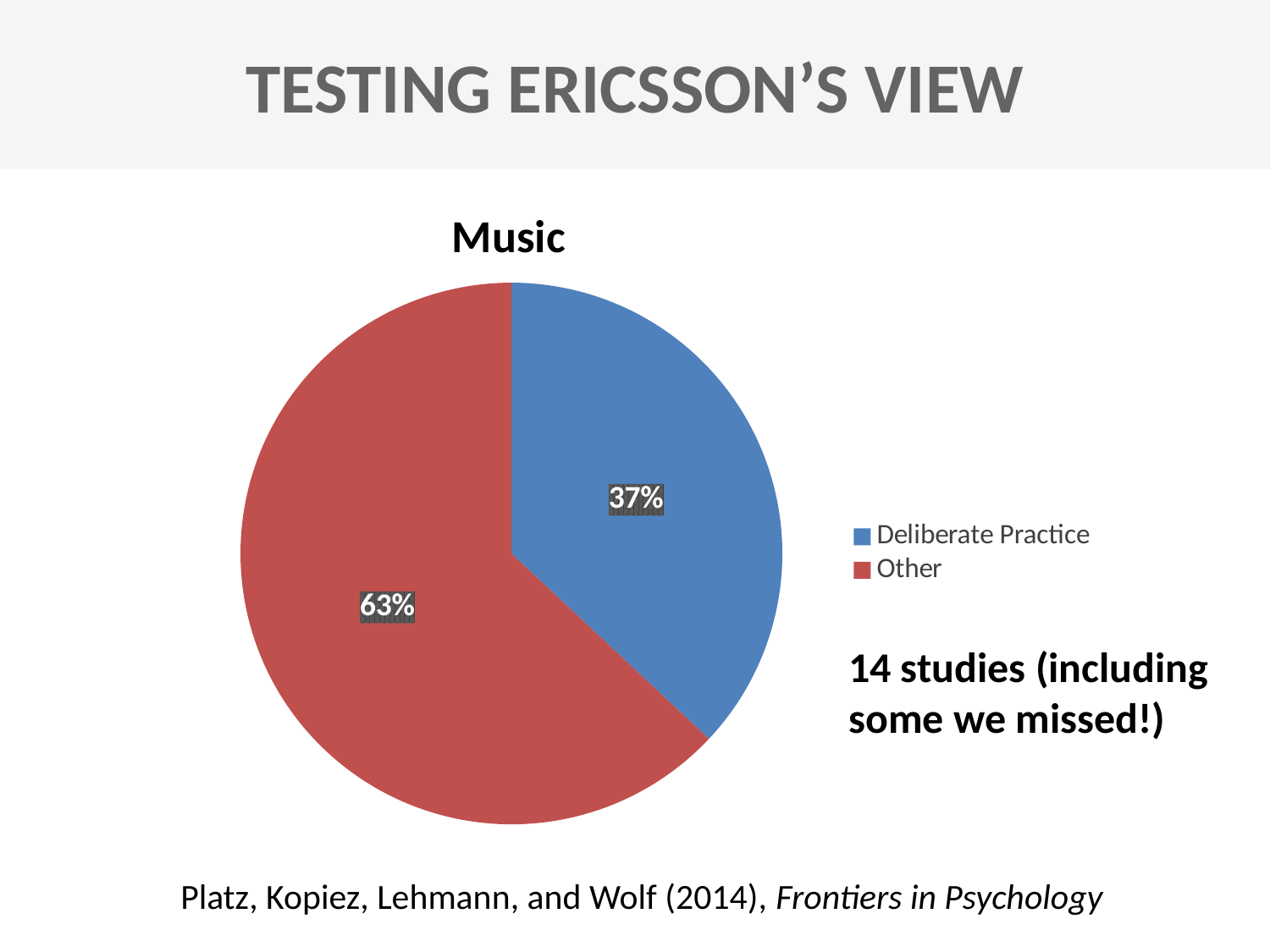
What kind of chart is shown on the slide? Pie chart What is the title of the chart? Music What share of the pie does Deliberate Practice account for? 37% Which is larger, the Deliberate Practice slice or the Other slice? Other How many entries does the legend list? 2 How many slices does the pie chart have? 2 What colour is the Deliberate Practice slice? Blue What share of the pie does Other account for? 63% Which slice of the pie is the smallest? Deliberate Practice Which slice of the pie is the largest? Other What is the difference in percentage points between the Other slice and the Deliberate Practice slice? 26